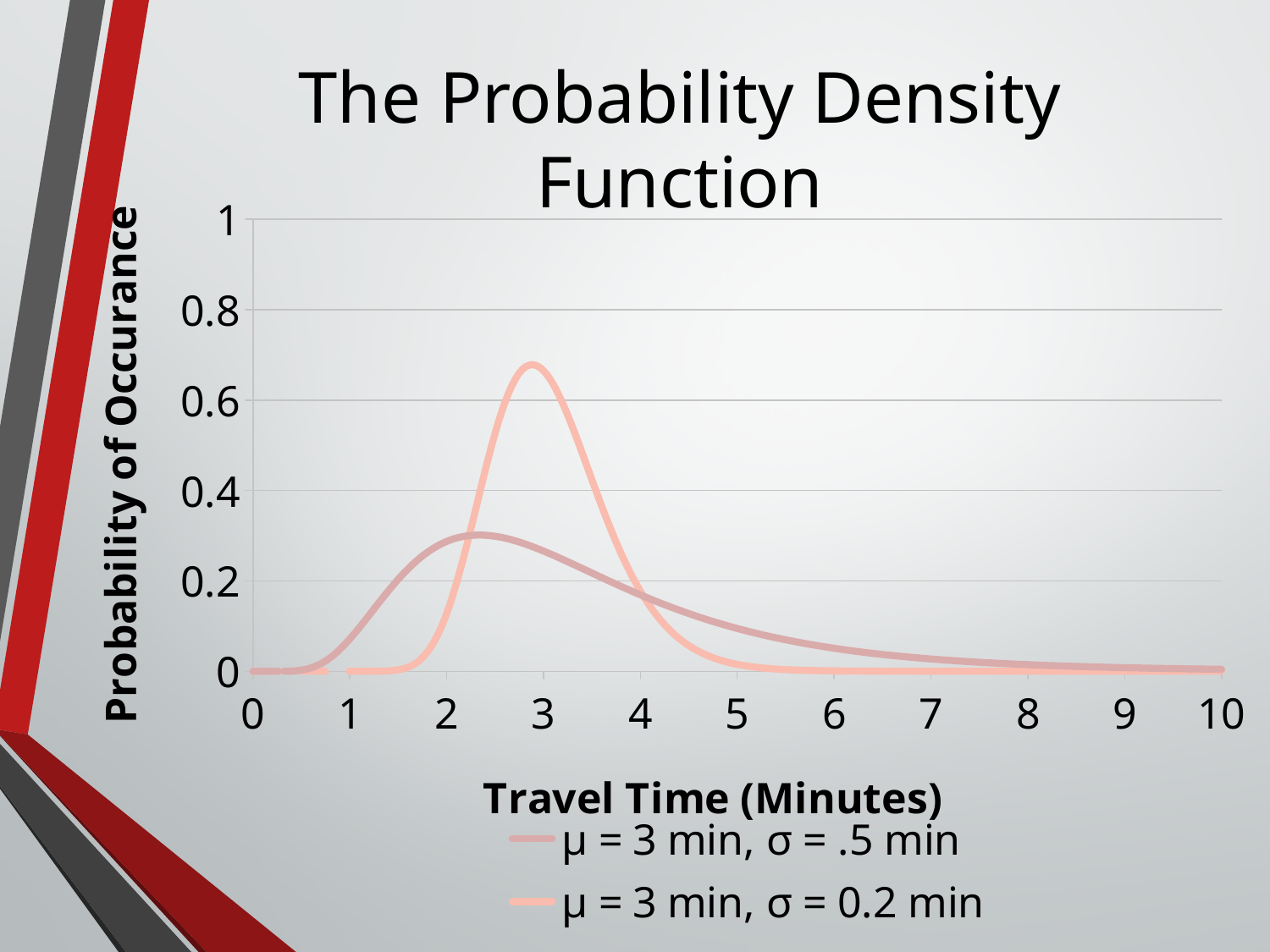
What is the title of the chart? The Probability Density Function Do the values of the μ = 3 min, σ = .5 min series rise or fall between travel times of 1 and 2 minutes? rise At a travel time of 3 minutes, which series has the larger value, μ = 3 min, σ = .5 min or μ = 3 min, σ = 0.2 min? μ = 3 min, σ = 0.2 min What kind of chart is shown on the slide? line chart Which series reaches the higher peak, μ = 3 min, σ = .5 min or μ = 3 min, σ = 0.2 min? μ = 3 min, σ = 0.2 min Is the peak value of the μ = 3 min, σ = .5 min series greater or less than 0.2? greater Is the peak value of the μ = 3 min, σ = 0.2 min series greater or less than 0.6? greater Is the value of the μ = 3 min, σ = 0.2 min series at a travel time of 5 minutes greater or less than 0.2? less What is the label of the x axis? Travel Time (Minutes) Do the values of the μ = 3 min, σ = 0.2 min series rise or fall between travel times of 3 and 5 minutes? fall How many series does the legend list? 2